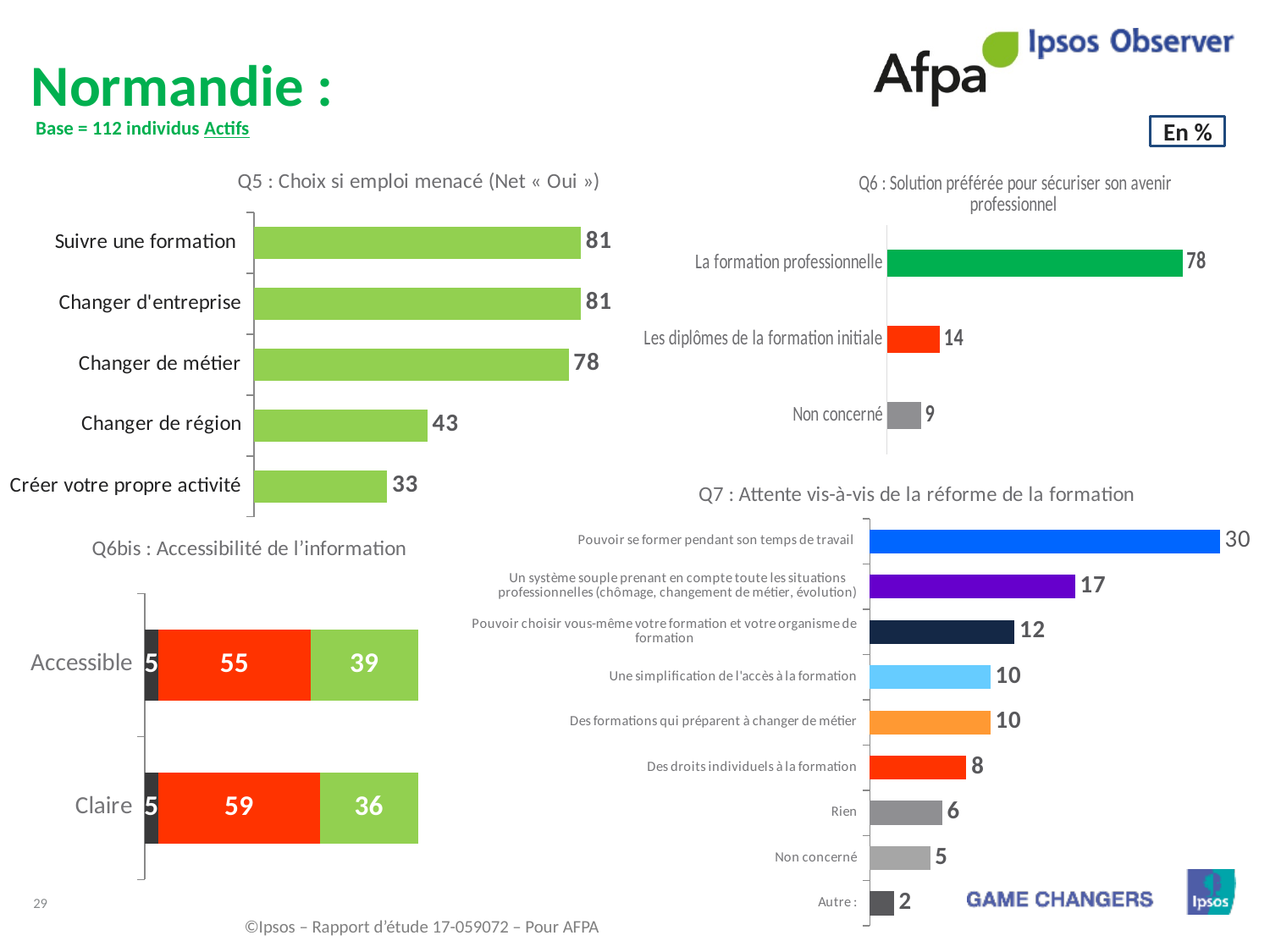
In the Q6bis chart (Accessibilité de l'information), what is the total of the stacked bar for "Claire"? 100 In the Q7 chart (Attente vis-à-vis de la réforme de la formation), how many categories are shown? 9 What type of chart is the Q7 chart (Attente vis-à-vis de la réforme de la formation)? Bar chart In the Q5 chart (Choix si emploi menacé), what is the difference between "Changer de métier" and "Créer votre propre activité"? 45 In the Q5 chart (Choix si emploi menacé), what is the value for "Changer de région"? 43 In the Q6bis chart (Accessibilité de l'information), what is the value of the middle (red) segment for "Accessible"? 55 In the Q6 chart (Solution préférée pour sécuriser son avenir professionnel), what is the value for "Les diplômes de la formation initiale"? 14 In the Q7 chart (Attente vis-à-vis de la réforme de la formation), which category has the lowest value? Autre : In the Q7 chart (Attente vis-à-vis de la réforme de la formation), what is the value for "Pouvoir se former pendant son temps de travail"? 30 In the Q5 chart (Choix si emploi menacé), which category has the lowest value? Créer votre propre activité In the Q6 chart (Solution préférée pour sécuriser son avenir professionnel), which category has the highest value? La formation professionnelle In the Q5 chart (Choix si emploi menacé), how many categories are shown? 5